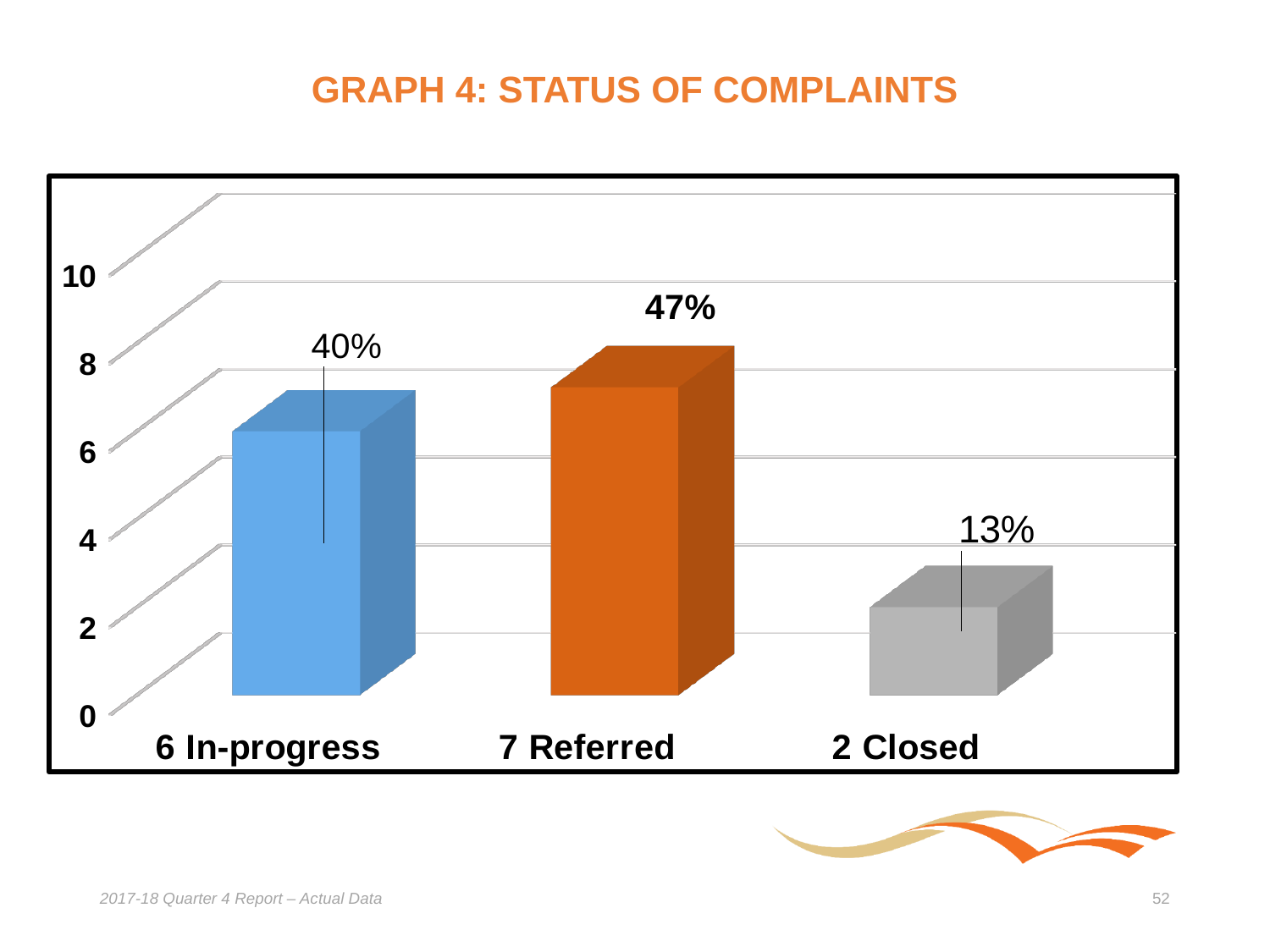
What percentage label is shown above the Closed bar? 13% Is the value for the Referred bar greater or less than 6 on the vertical axis? greater Which status category has the lowest bar? 2 Closed What type of chart is shown on the slide? Bar chart What percentage label is shown above the Referred bar? 47% By how many percentage points does the Referred label exceed the In-progress label? 7 How many status categories are shown on the chart? 3 Which status category has the highest bar? 7 Referred Which is larger, the In-progress bar or the Closed bar? In-progress Is the value for the Closed bar greater or less than 4 on the vertical axis? less What percentage label is shown above the In-progress bar? 40% By how many percentage points does the In-progress label exceed the Closed label? 27